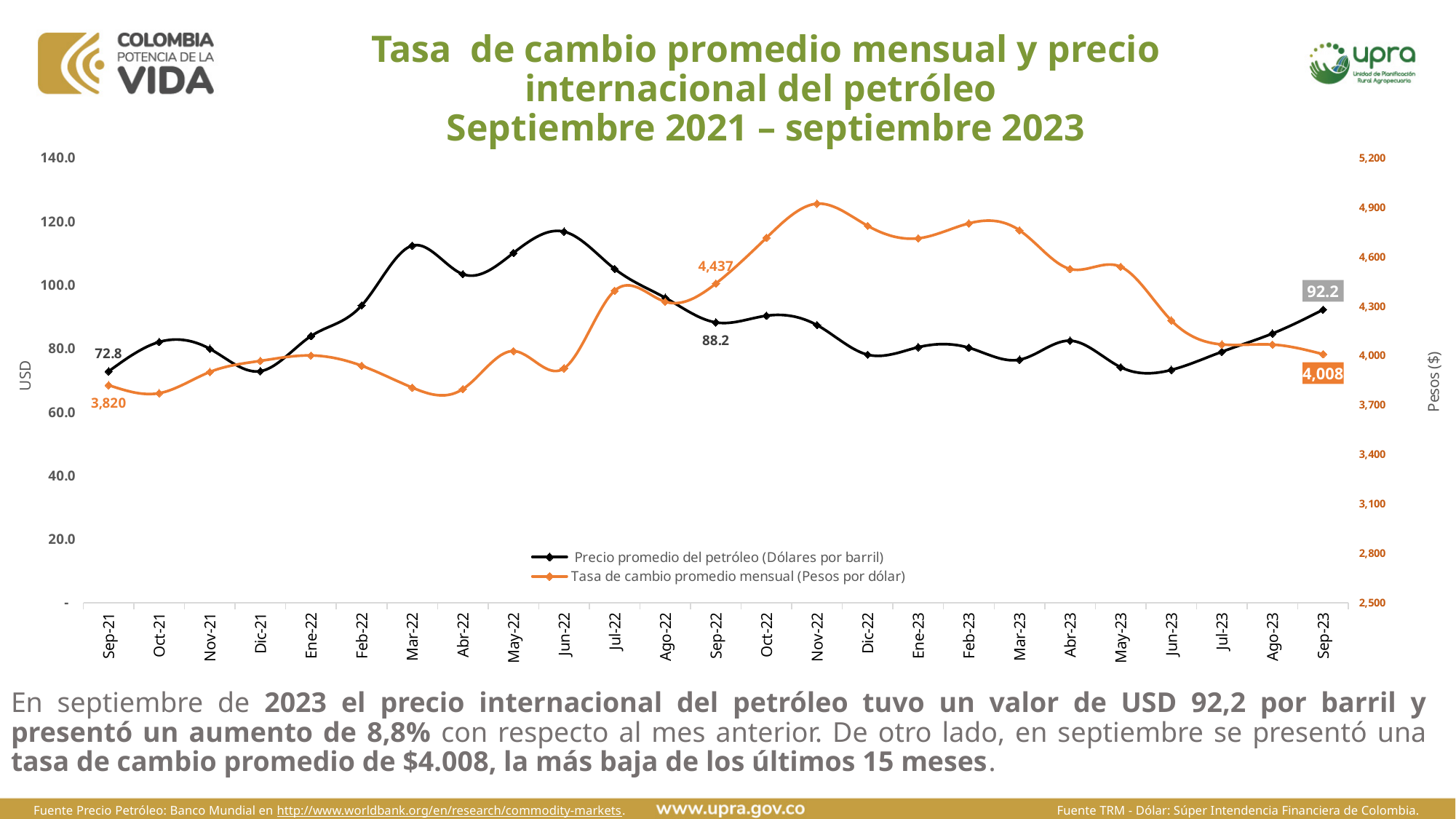
Is the oil price in Mar-22 greater or less than 100.0? greater What was the average monthly exchange rate (Pesos por dólar) in Sep-22? 4,437 What was the average monthly exchange rate in Sep-21? 3,820 What type of chart is shown on the slide? Line chart Which is larger, the exchange rate in Sep-22 or in Sep-23? Sep-22 How many series does the legend list? 2 Which month shows the highest oil price (Dólares por barril)? Jun-22 Which month shows the highest exchange rate (Pesos por dólar)? Nov-22 How many months are plotted along the x axis? 25 What was the average oil price (Dólares por barril) in Sep-23? 92.2 By how much did the exchange rate fall from Sep-22 (4,437) to Sep-23 (4,008)? 429 What is the difference between the oil price in Sep-23 (92.2) and in Sep-22 (88.2)? 4.0